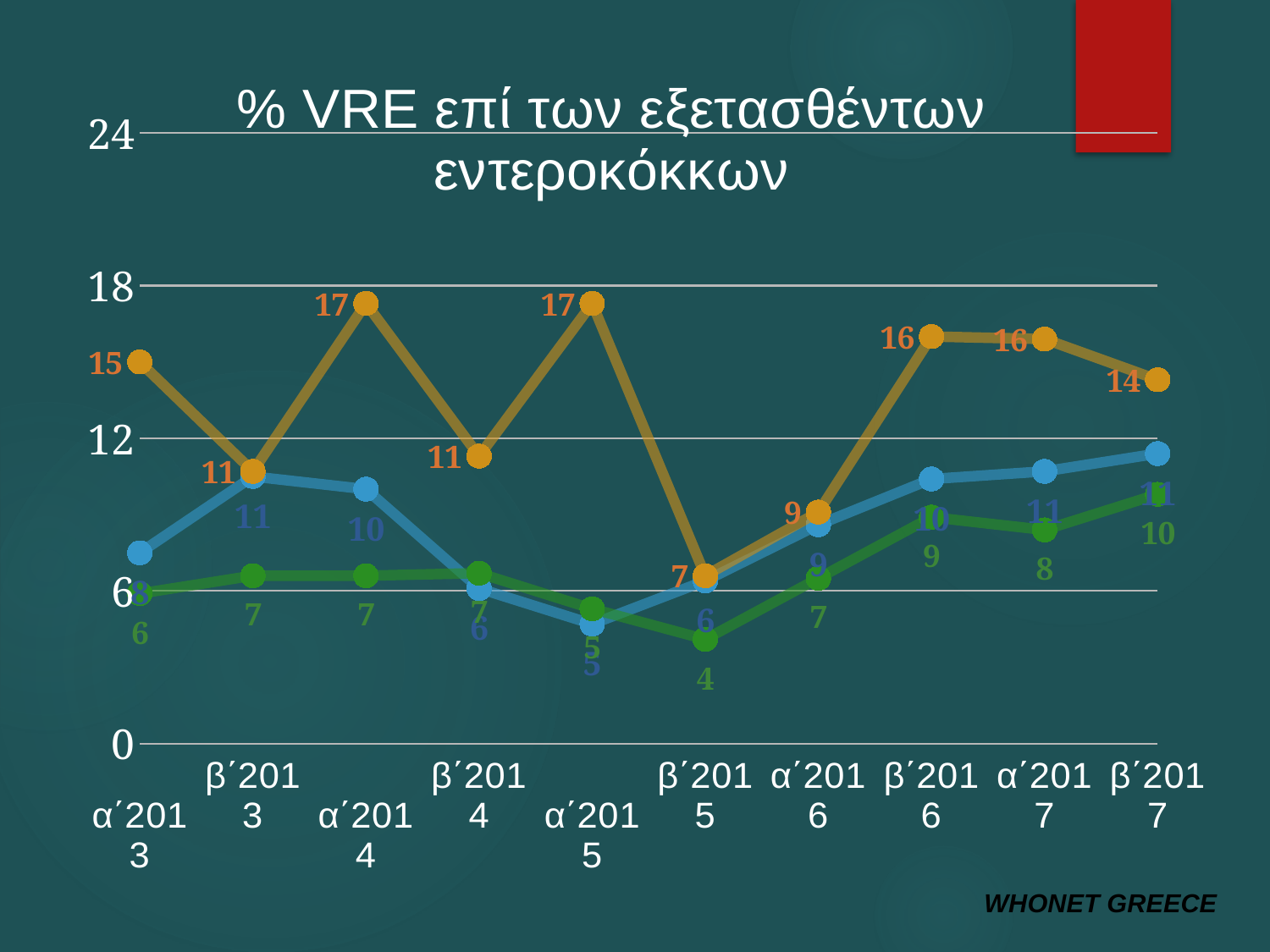
How many time periods are shown on the x axis? 10 What type of chart is shown on the slide? line chart Is the value of the orange series at α΄2013 greater or less than 12? greater Does the orange series rise or fall from β΄2016 to β΄2017? fall What is the value of the orange series at β΄2015? 7 At which period is the green series highest? β΄2017 What is the value of the green series at β΄2015? 4 What is the title of the chart? % VRE επί των εξετασθέντων εντεροκόκκων What is the value of the blue series at β΄2013? 11 What is the value of the orange series at α΄2013? 15 What is the difference between the orange series values at α΄2014 and β΄2014? 6 At which period is the orange series lowest? β΄2015